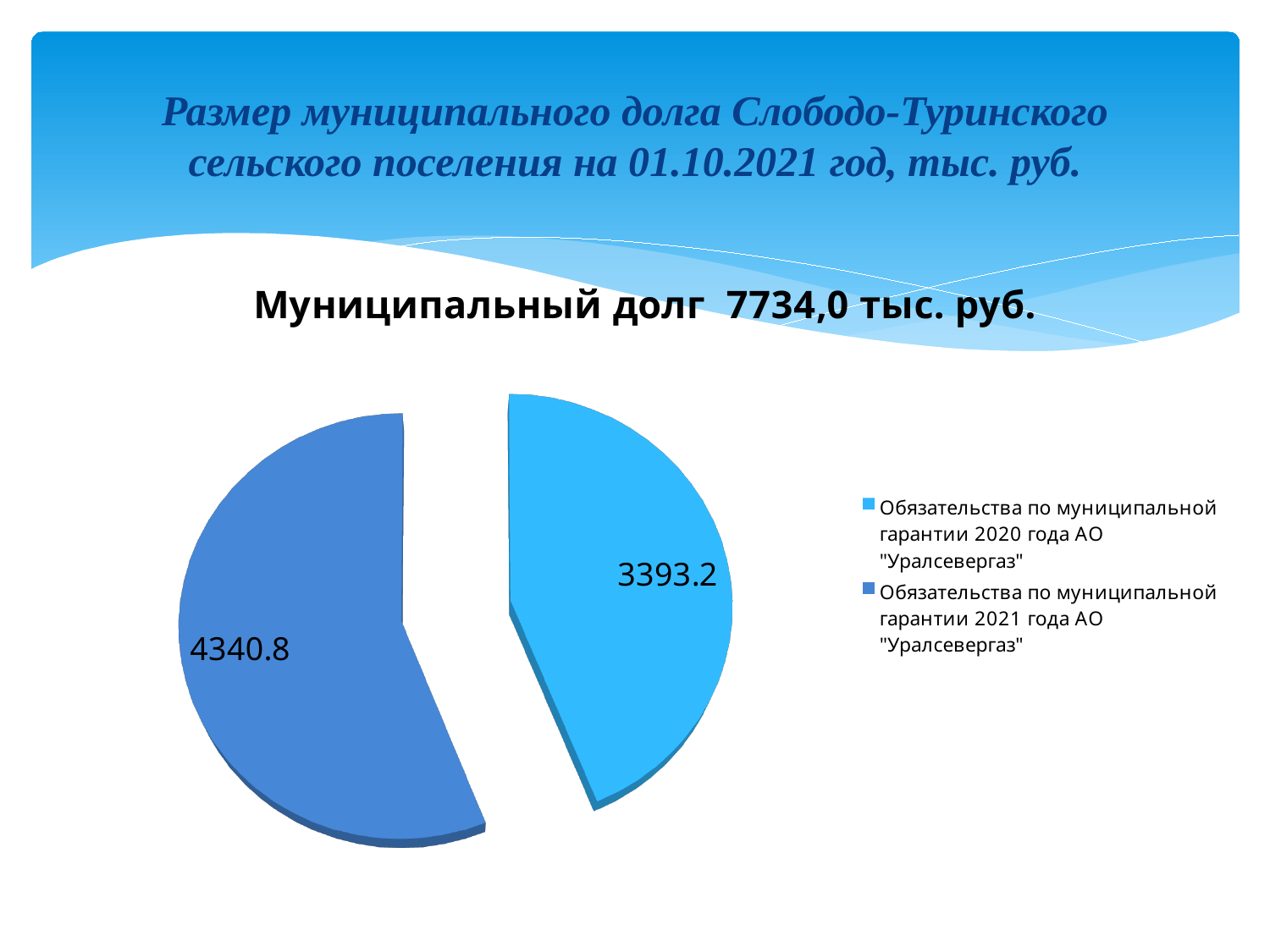
What share of the total municipal debt (7734.0) is the 2021 guarantee slice of 4340.8? 56.1% How many slices does the pie chart have? 2 How many entries does the legend list? 2 Which slice is the largest in the pie chart? Обязательства по муниципальной гарантии 2021 года АО "Уралсевергаз" What is the difference between the 2021 guarantee obligations and the 2020 guarantee obligations? 947.6 Which colour represents the 2020 guarantee obligations in the pie chart? Light blue What is the value of the slice for obligations under the 2021 municipal guarantee to AO "Уралсевергаз"? 4340.8 What is the value of the slice for obligations under the 2020 municipal guarantee to AO "Уралсевергаз"? 3393.2 What is the total municipal debt stated on the slide? 7734,0 тыс. руб. Which is larger: the 2020 guarantee obligations or the 2021 guarantee obligations? 2021 guarantee obligations What kind of chart is shown on the slide? Pie chart Which slice is the smallest in the pie chart? Обязательства по муниципальной гарантии 2020 года АО "Уралсевергаз"